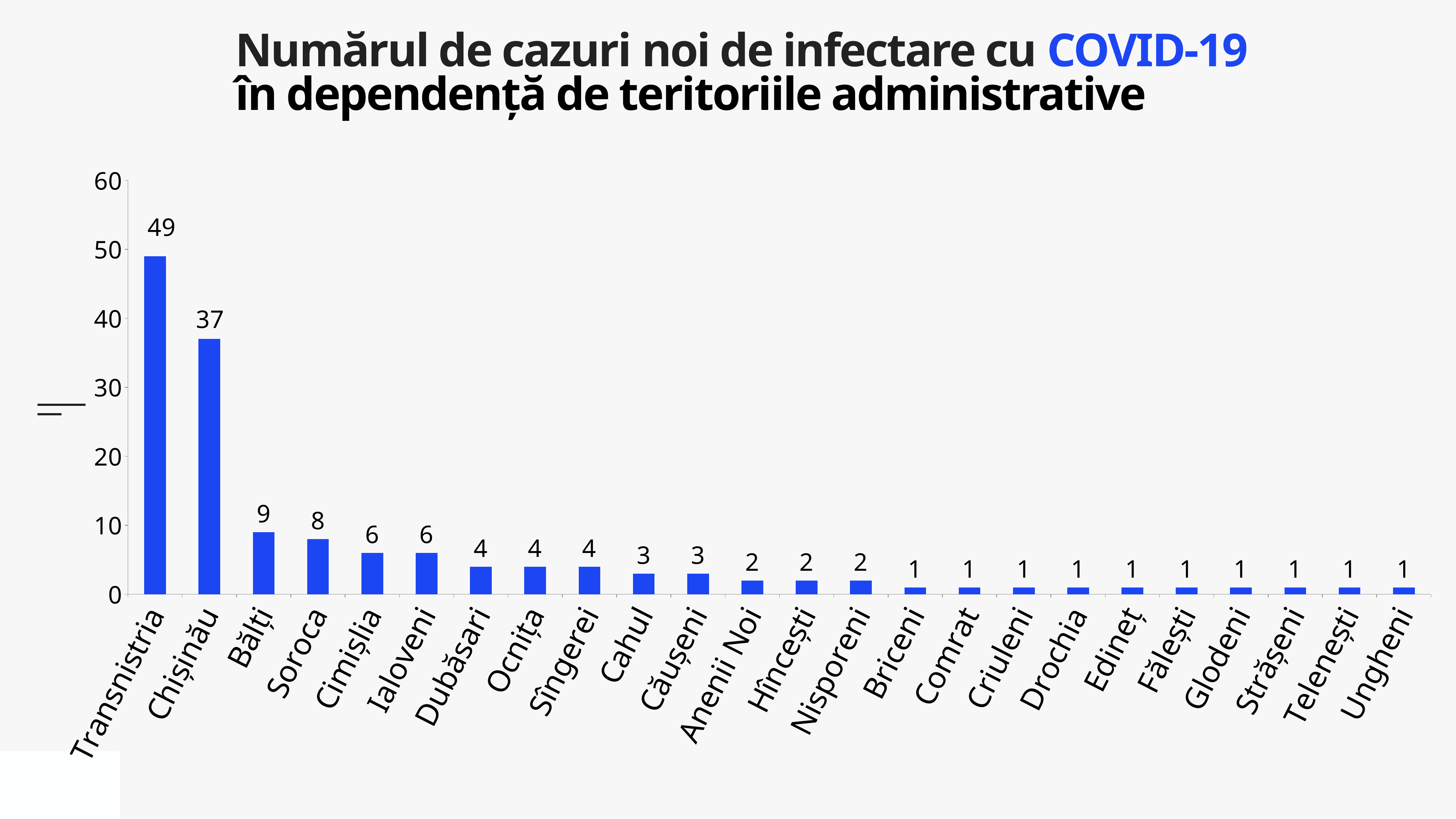
Do the values rise or fall moving from left to right along the x axis? fall What is the difference between the values for Transnistria and Chișinău? 12 How many territories are shown on the x axis? 24 What is the number of new COVID-19 cases for Chișinău? 37 Which has a larger value, Cimișlia or Dubăsari? Cimișlia Is the value for Chișinău greater or less than 40? less What is the value shown for Soroca? 8 What is the number of new COVID-19 cases for Transnistria? 49 Which territory has the highest number of new cases? Transnistria What kind of chart is shown on the slide? bar chart What is the value shown for Cahul? 3 What is the difference between the values for Bălți and Soroca? 1